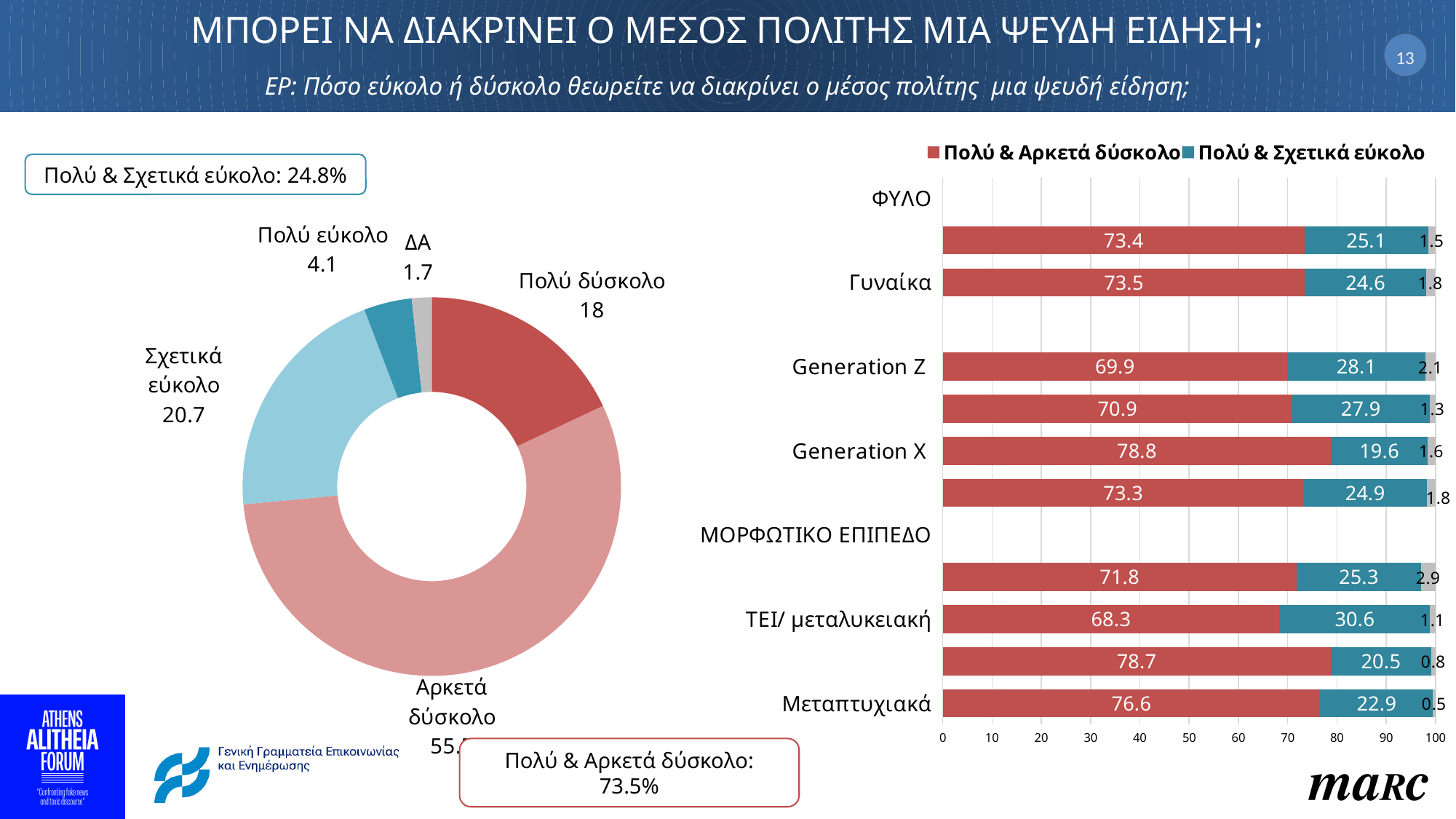
In the bar chart on the right, how much larger is the Πολύ & Αρκετά δύσκολο value for Generation X than for Generation Z? 8.9 How many series does the legend of the bar chart on the right list? 2 In the bar chart on the right, what is the Πολύ & Αρκετά δύσκολο value for Γυναίκα? 73.5 In the donut chart on the left, what is the value for Πολύ δύσκολο? 18 In the donut chart on the left, which category has the smallest slice? ΔΑ In the donut chart on the left, what is the difference between Σχετικά εύκολο and Πολύ εύκολο? 16.6 In the bar chart on the right, what is the Πολύ & Σχετικά εύκολο value for Generation Z? 28.1 In the bar chart on the right, what is the Πολύ & Αρκετά δύσκολο value for Generation X? 78.8 In the bar chart on the right, what is the Πολύ & Σχετικά εύκολο value for ΤΕΙ/ μεταλυκειακή? 30.6 In the bar chart on the right, which has the larger Πολύ & Αρκετά δύσκολο value, Generation Z or Generation X? Generation X In the donut chart on the left, what is the value for Σχετικά εύκολο? 20.7 In the bar chart on the right, what is the Πολύ & Αρκετά δύσκολο value for Μεταπτυχιακά? 76.6